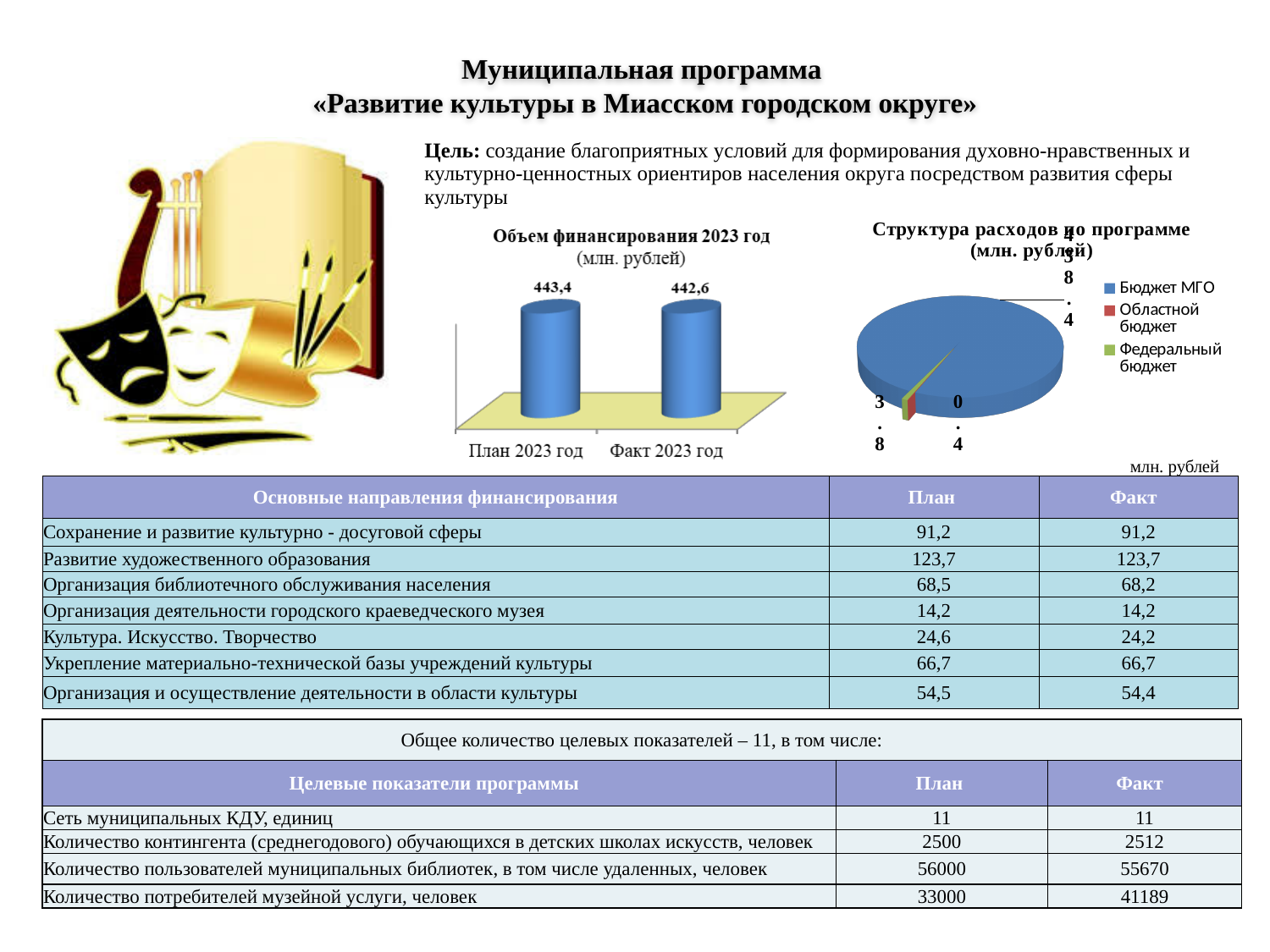
How many bars are shown in the chart 'Объем финансирования 2023 год'? 2 How many entries does the legend of the chart 'Структура расходов по программе' list? 3 In the bar chart 'Объем финансирования 2023 год', what is the value for Факт 2023 год? 442,6 In the bar chart 'Объем финансирования 2023 год', what is the difference between План 2023 год and Факт 2023 год? 0,8 What kind of chart is 'Объем финансирования 2023 год'? bar chart What kind of chart is 'Структура расходов по программе'? pie chart In the bar chart 'Объем финансирования 2023 год', which category has the higher value? План 2023 год In the pie chart 'Структура расходов по программе', what unit is given in the title? млн. рублей In the bar chart 'Объем финансирования 2023 год', is the value for План 2023 год larger or smaller than the value for Факт 2023 год? larger In the bar chart 'Объем финансирования 2023 год', what is the value for План 2023 год? 443,4 In the bar chart 'Объем финансирования 2023 год', which category has the lower value? Факт 2023 год In the pie chart 'Структура расходов по программе', which category has the largest slice? Бюджет МГО